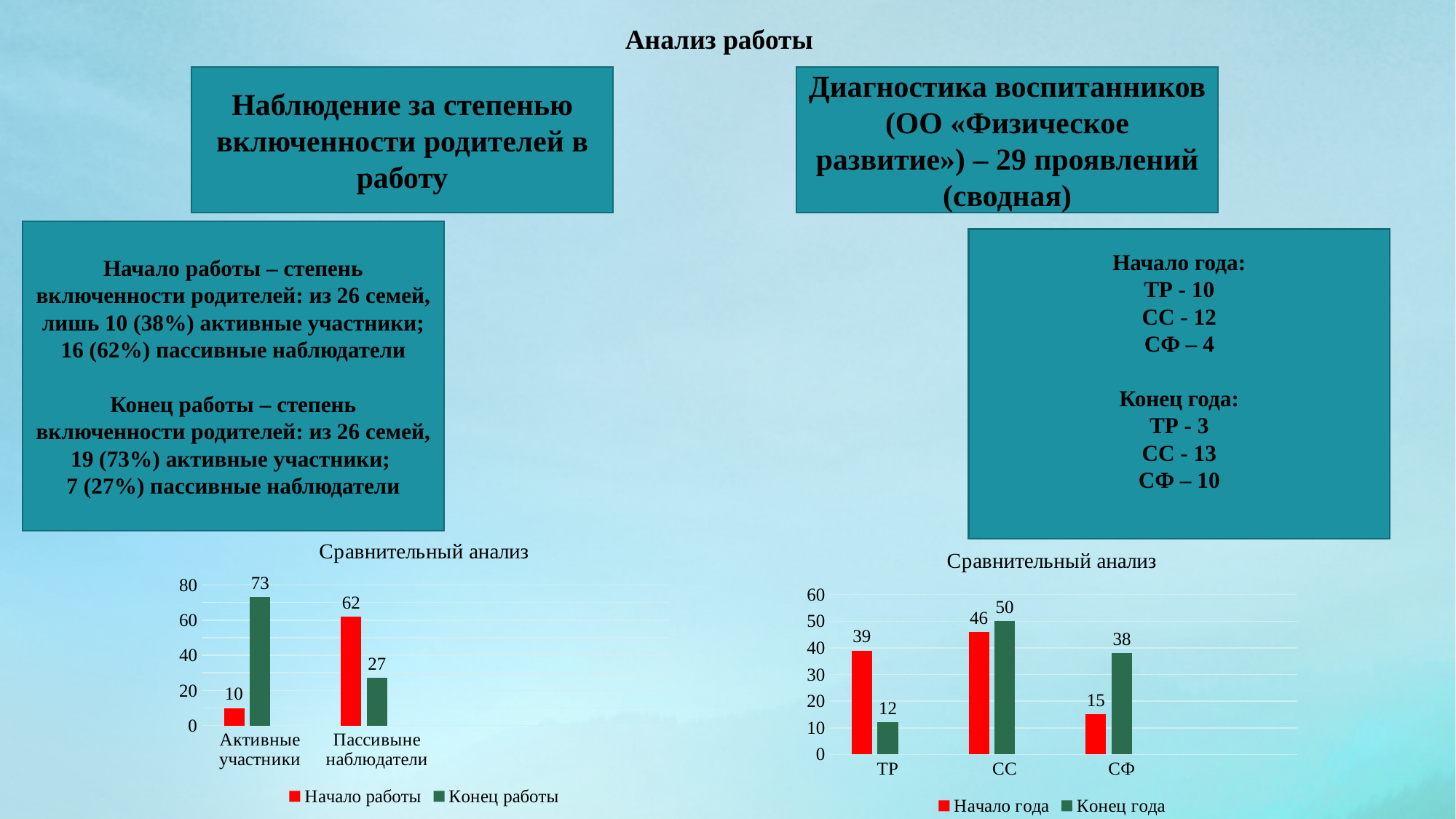
In the left chart (Сравнительный анализ), what is the value of Конец работы for Активные участники? 73 In the left chart, which series has the larger value for Пассивыне наблюдатели, Начало работы or Конец работы? Начало работы What type of chart is the left chart on the slide? Bar chart In the left chart, what is the value of Начало работы for Пассивыне наблюдатели? 62 In the left chart, how many series does the legend list? 2 In the right chart (Сравнительный анализ), what is the value of Начало года for ТР? 39 In the right chart, which category has the lowest Начало года value? СФ In the right chart, what is the value of Конец года for СФ? 38 How many categories are shown on the x axis of the right chart? 3 In the right chart, which category has the highest Конец года value? СС In the right chart, what is the difference between Начало года and Конец года for ТР? 27 In the left chart, what is the difference between Конец работы and Начало работы for Активные участники? 63